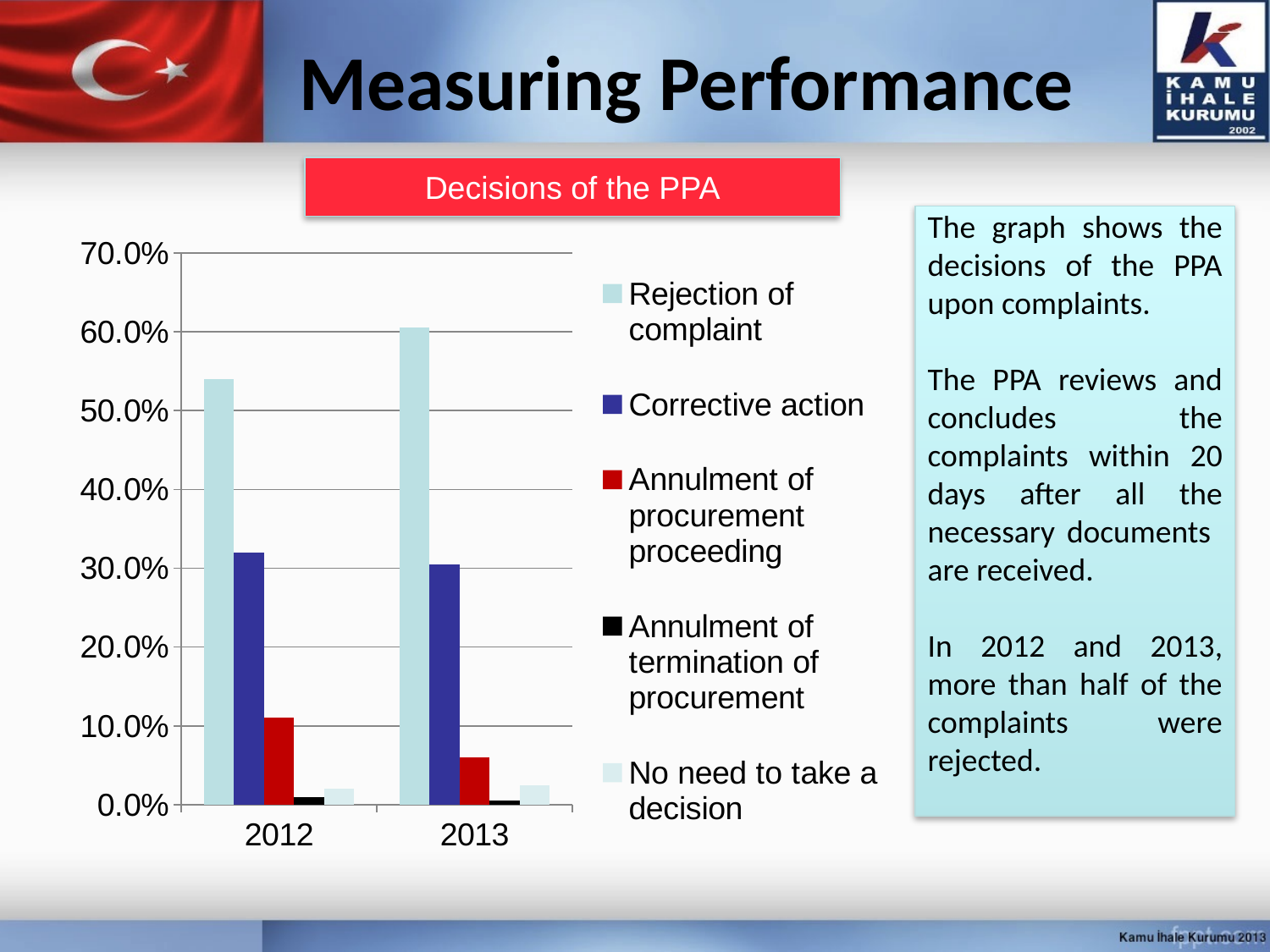
Which decision type has the highest value in 2012? Rejection of complaint Is the value for Corrective action in 2013 greater or less than 40.0%? less Which year has the larger value for Rejection of complaint, 2012 or 2013? 2013 Which year has the larger value for Annulment of procurement proceeding, 2012 or 2013? 2012 What kind of chart is shown on the slide? bar chart What is the title of the chart? Decisions of the PPA Does the value for Rejection of complaint rise or fall from 2012 to 2013? rise Which decision type has the lowest value in 2013? Annulment of termination of procurement How many years are shown on the x axis? 2 Is the value for Annulment of procurement proceeding in 2012 greater or less than 20.0%? less How many series does the legend list? 5 Is the value for Rejection of complaint in 2012 greater or less than 50.0%? greater